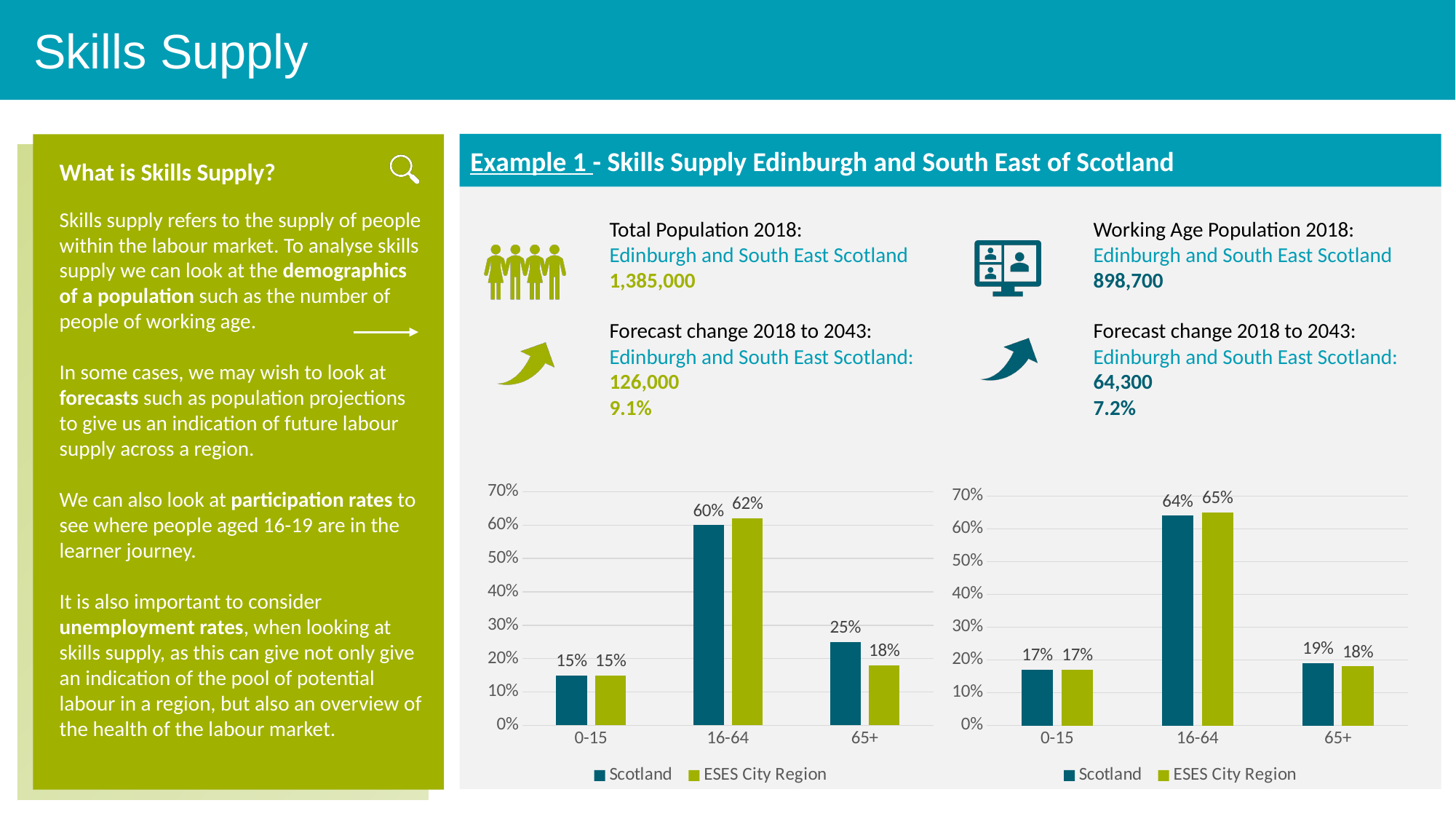
In the left chart, what is the value for ESES City Region in the 65+ age group? 18% How many age groups are shown on the x axis of the right chart? 3 In the left chart, which is larger in the 65+ age group, Scotland or ESES City Region? Scotland How many series does the legend of the left chart list? 2 In the left chart, what is the difference between Scotland and ESES City Region in the 65+ age group? 7% What type of chart is the right chart? Bar chart In the right chart, what is the difference between ESES City Region and Scotland in the 16-64 age group? 1% In the right chart, what is the value for ESES City Region in the 16-64 age group? 65% In the left chart, what is the value for Scotland in the 16-64 age group? 60% In the right chart, what is the value for Scotland in the 0-15 age group? 17% In the right chart, which age group has the lowest value for ESES City Region? 0-15 In the left chart, which age group has the highest value for Scotland? 16-64